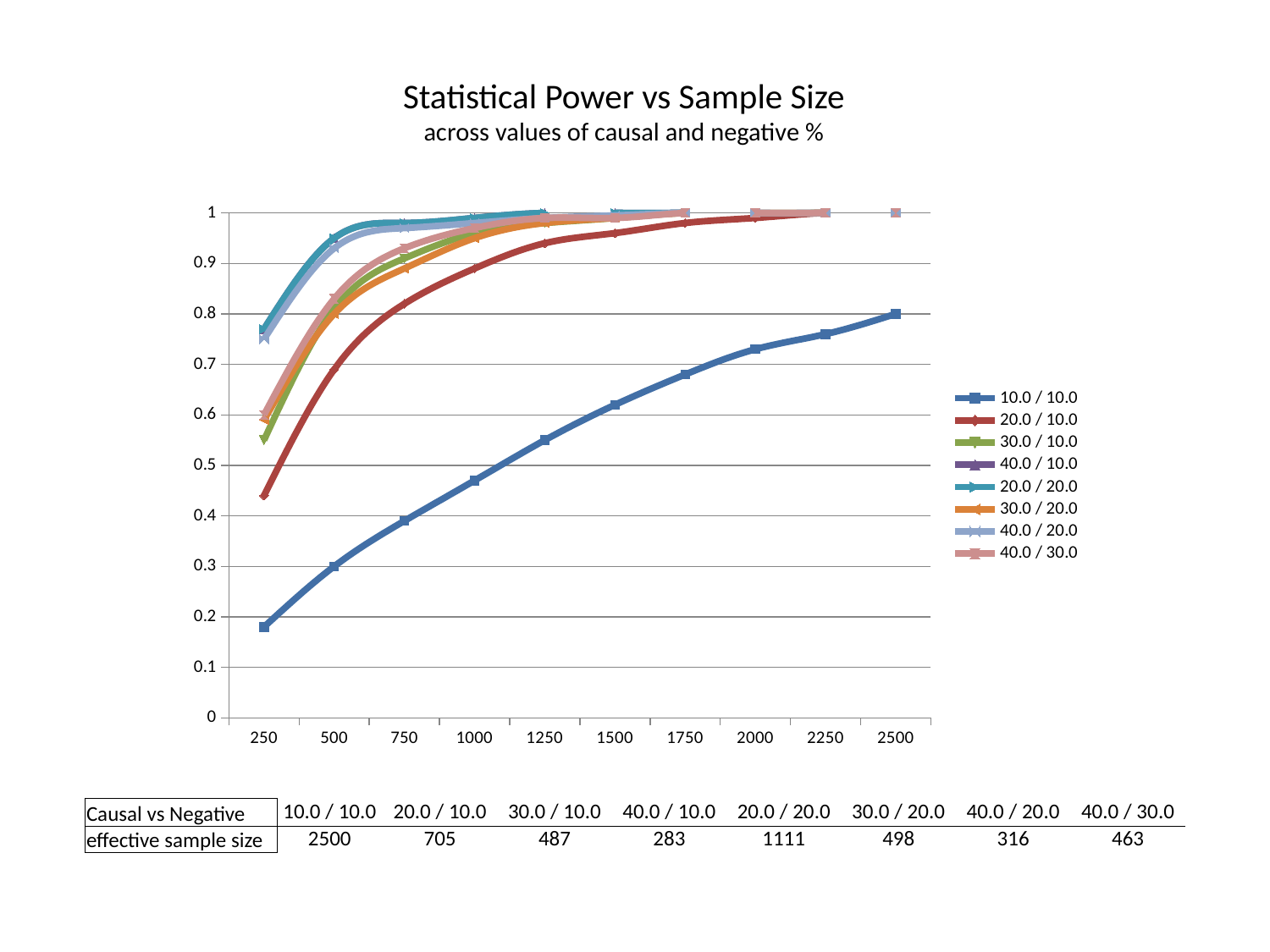
What is the subtitle shown under the chart title? across values of causal and negative % What kind of chart is shown on the slide? line chart Which series has the lowest value at sample size 2500? 10.0 / 10.0 Is the value for the 20.0 / 10.0 series at sample size 1000 greater or less than 0.8? greater Is the value for the 10.0 / 10.0 series at sample size 250 greater or less than 0.2? less Is the value for the 10.0 / 10.0 series at sample size 1500 greater or less than 0.6? greater How many series does the legend list? 8 Does the 10.0 / 10.0 series rise or fall as sample size increases? rise At sample size 1000, which series has the larger value, 20.0 / 10.0 or 10.0 / 10.0? 20.0 / 10.0 What is the title of the chart? Statistical Power vs Sample Size How many sample-size values are marked along the x axis? 10